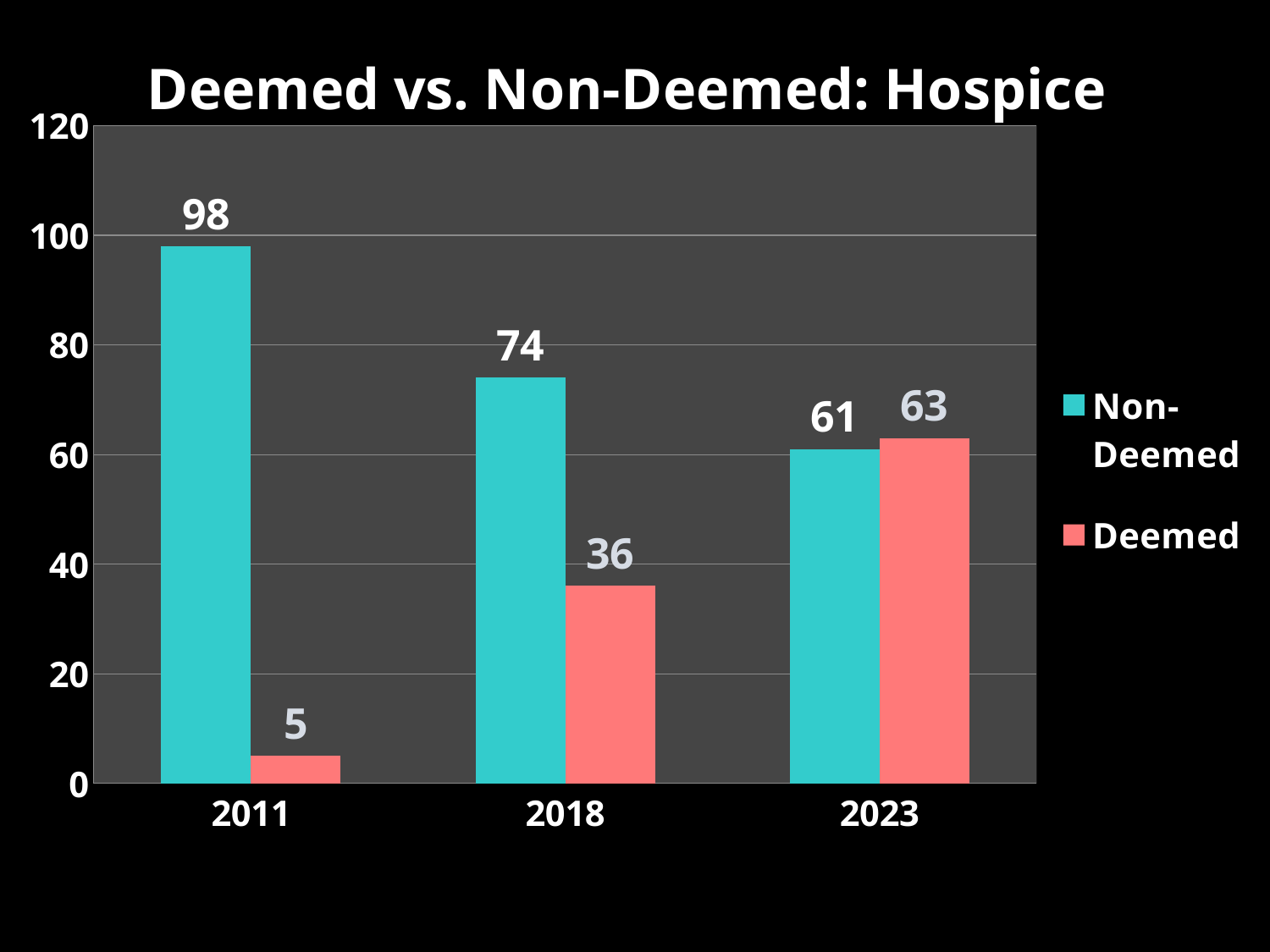
What is the difference between the Non-Deemed values for 2011 and 2018? 24 What is the Deemed value for 2018? 36 Do the Deemed values rise or fall from 2011 to 2023? Rise What is the difference between the Non-Deemed and Deemed values in 2011? 93 What is the Non-Deemed value for 2011? 98 Which year has the lowest Deemed value? 2011 How many series does the legend list? 2 How many years are shown on the x axis? 3 In 2018, which is larger, the Non-Deemed value or the Deemed value? Non-Deemed What is the Deemed value for 2023? 63 What kind of chart is shown on the slide? Bar chart Which year has the highest Non-Deemed value? 2011